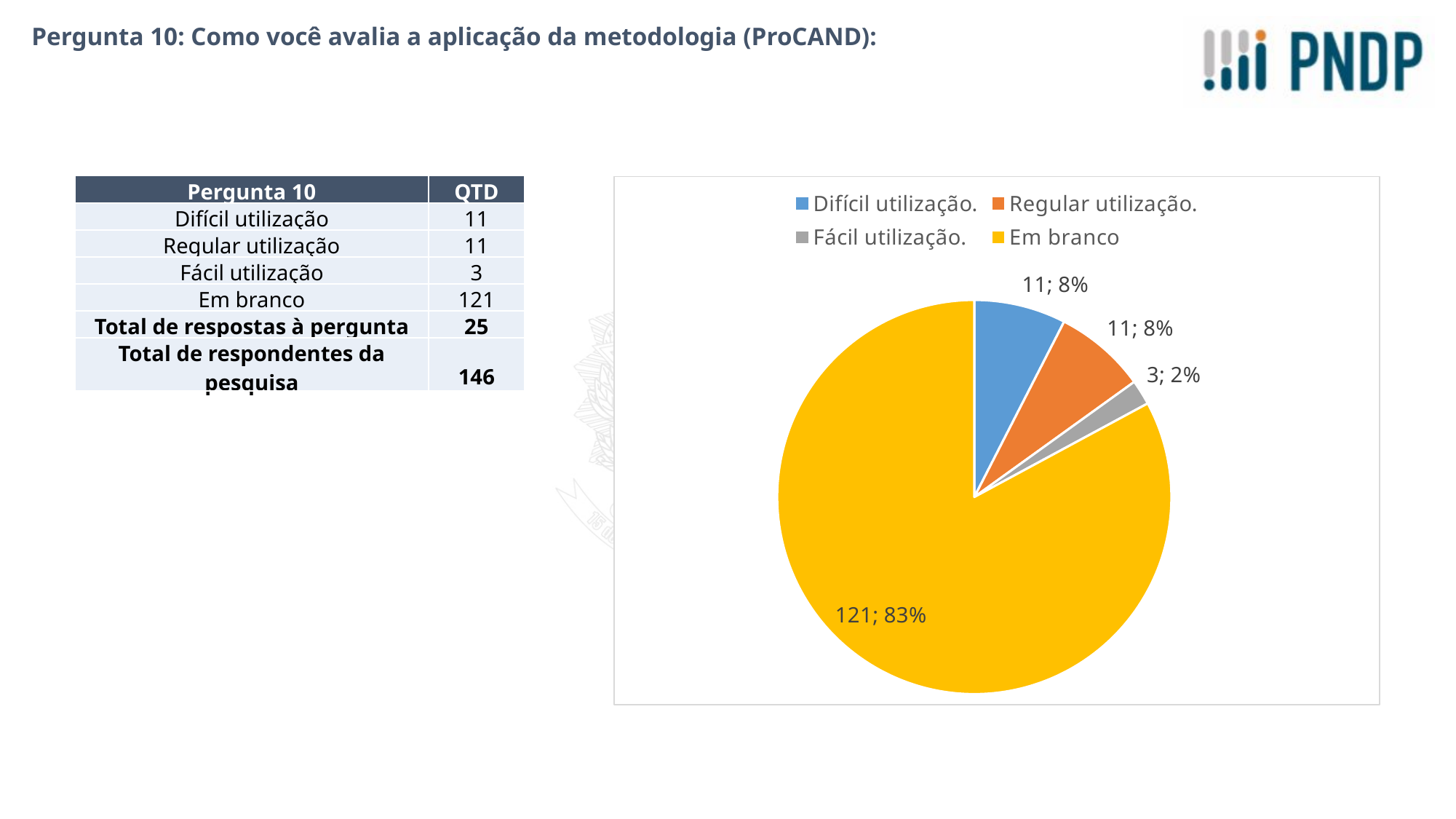
What is the value shown for the 'Difícil utilização' slice? 11 Which colour represents 'Em branco' in the pie chart? Yellow How many slices does the pie chart have? 4 Which category has the largest slice in the pie chart? Em branco Which category has the smallest slice in the pie chart? Fácil utilização What type of chart is shown on the slide? Pie chart How many entries does the legend of the pie chart list? 4 What is the value shown for the 'Em branco' slice? 121 What percentage share does the 'Em branco' slice represent? 83% What is the difference between the 'Em branco' value and the 'Fácil utilização' value? 118 What percentage share does the 'Regular utilização' slice represent? 8% What is the value shown for the 'Fácil utilização' slice? 3